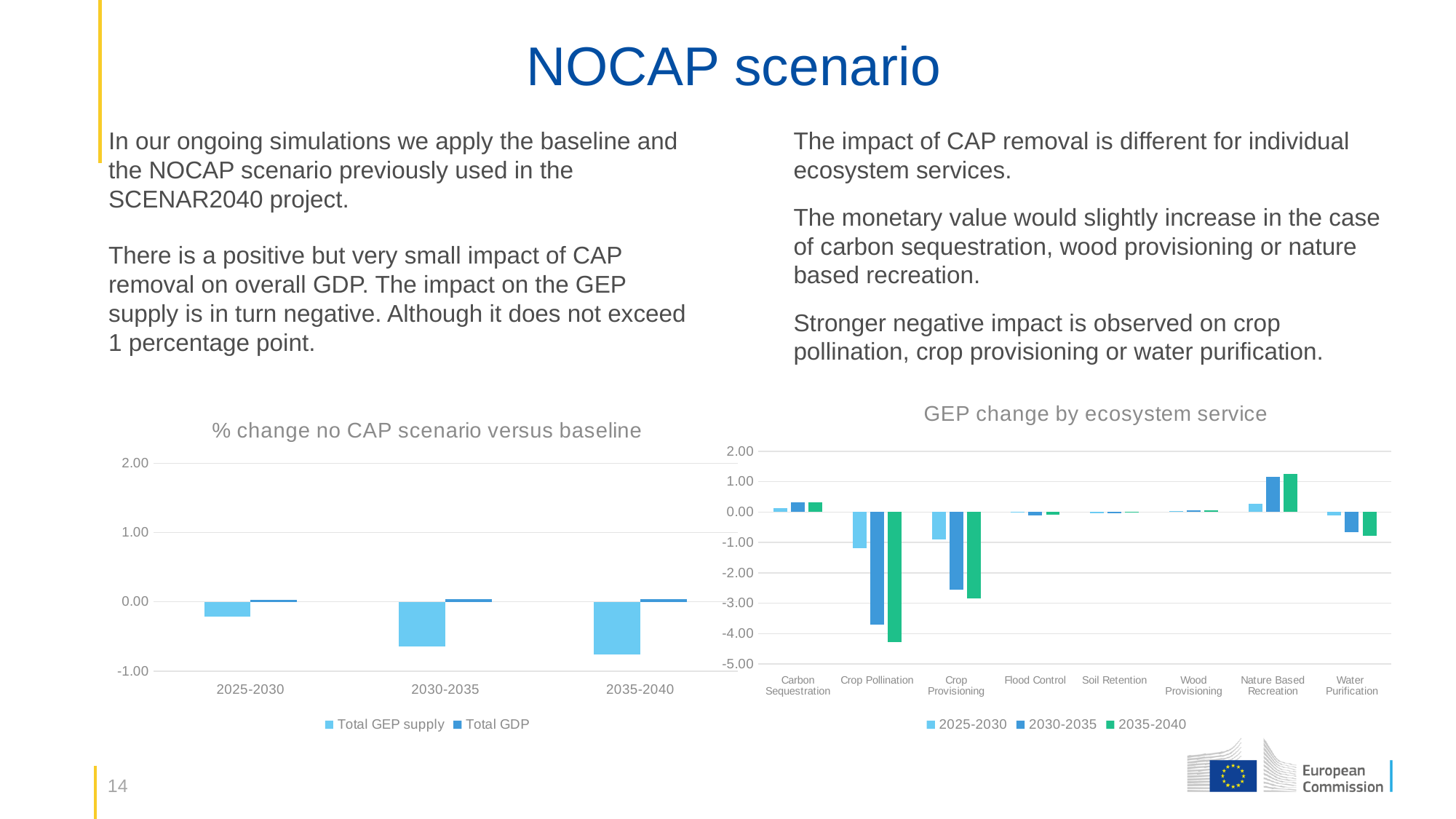
In the right chart 'GEP change by ecosystem service', which ecosystem service has the lowest value for 2035-2040? Crop Pollination How many series does the legend of the right chart 'GEP change by ecosystem service' list? 3 How many periods are shown on the x axis of the left chart '% change no CAP scenario versus baseline'? 3 In the left chart '% change no CAP scenario versus baseline', is the Total GEP supply value for 2035-2040 greater or less than -1.00? greater In the left chart '% change no CAP scenario versus baseline', which period has the lowest Total GEP supply value? 2035-2040 In the left chart '% change no CAP scenario versus baseline', does the Total GEP supply value rise or fall from 2025-2030 to 2035-2040? fall In the right chart 'GEP change by ecosystem service', which ecosystem service has the highest value for 2035-2040? Nature Based Recreation In the right chart 'GEP change by ecosystem service', is the 2035-2040 value for Crop Pollination greater or less than -4.00? less In the left chart '% change no CAP scenario versus baseline', is the Total GEP supply value for 2030-2035 greater or less than 0.00? less What kind of chart is the left chart titled '% change no CAP scenario versus baseline'? bar chart How many ecosystem services are shown on the x axis of the right chart 'GEP change by ecosystem service'? 8 How many series does the legend of the left chart '% change no CAP scenario versus baseline' list? 2